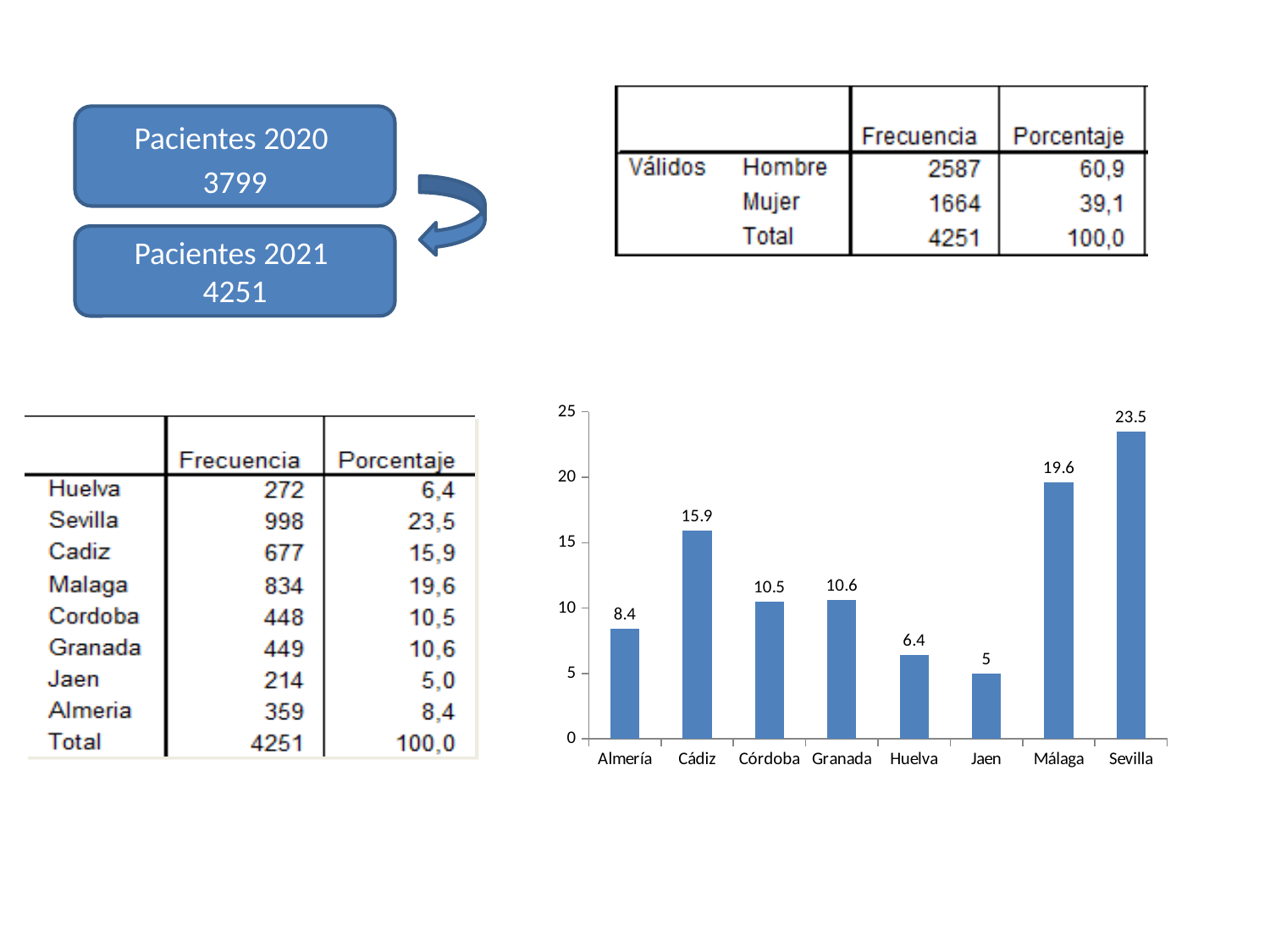
What is the value shown for Sevilla in the bar chart? 23.5 What is the highest value marked on the y axis of the bar chart? 25 Which category has the highest bar in the chart? Sevilla What is the value shown for Jaen in the bar chart? 5 What is the difference between the values for Sevilla and Málaga in the bar chart? 3.9 What is the value shown for Cádiz in the bar chart? 15.9 Is the value for Almería in the bar chart greater or less than 10? less How many categories are shown on the x axis of the bar chart? 8 In the bar chart, which is larger, the value for Málaga or the value for Cádiz? Málaga What kind of chart is shown on the slide? bar chart What is the difference between the values for Cádiz and Huelva in the bar chart? 9.5 Which category has the lowest bar in the chart? Jaen